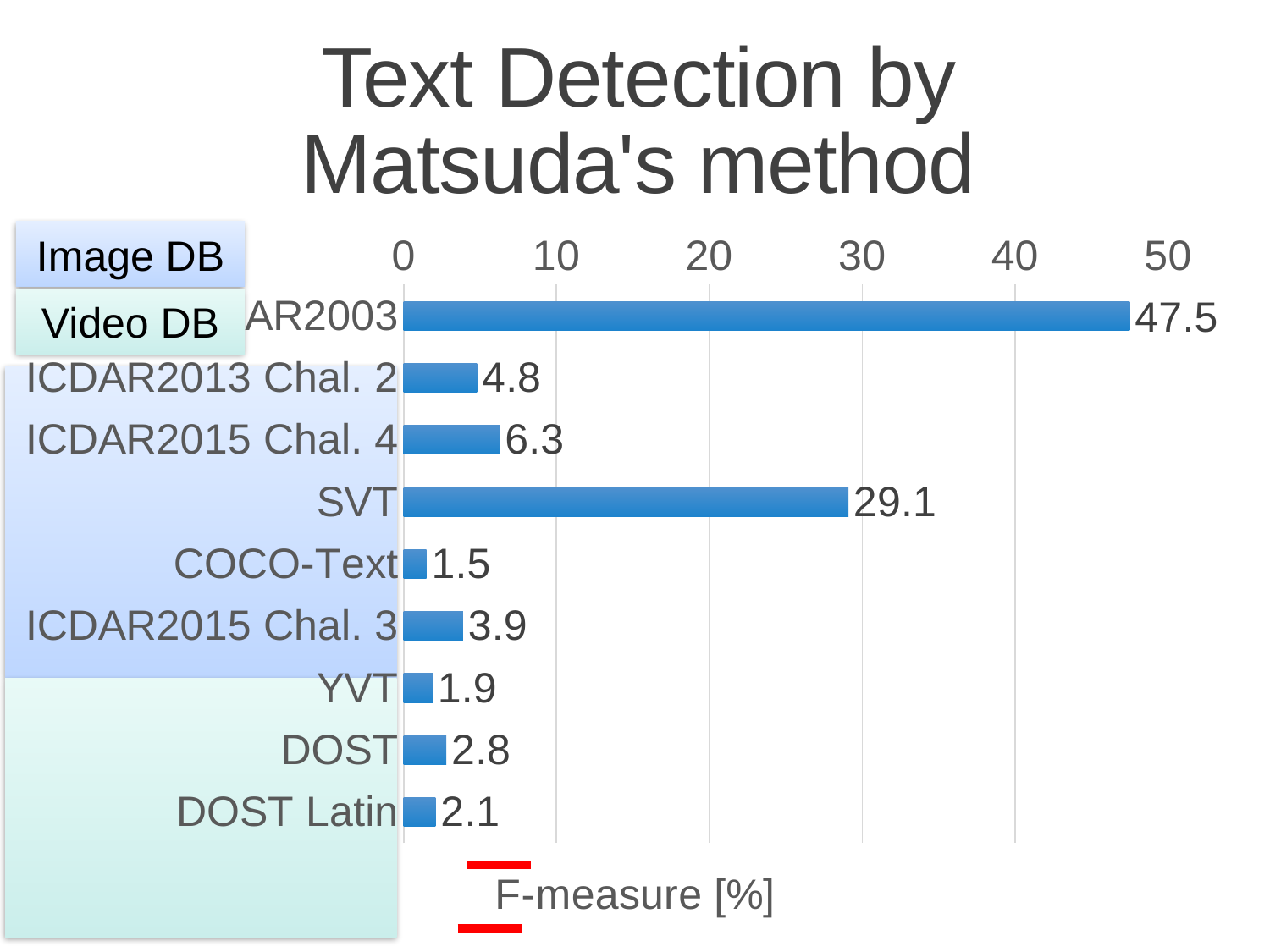
What is the F-measure value for SVT? 29.1 What is the F-measure value for ICDAR2015 Chal. 4? 6.3 Which has a higher F-measure, DOST or DOST Latin? DOST What is the highest F-measure value shown in the chart? 47.5 What is the F-measure value for DOST? 2.8 Which dataset has the lowest F-measure? COCO-Text What is the F-measure value for COCO-Text? 1.5 What is the label of the horizontal axis? F-measure [%] What kind of chart is shown on the slide? bar chart How many datasets are plotted in the chart? 9 What is the difference between the F-measure for SVT and for ICDAR2015 Chal. 4? 22.8 Is the value for SVT greater or less than 20? greater